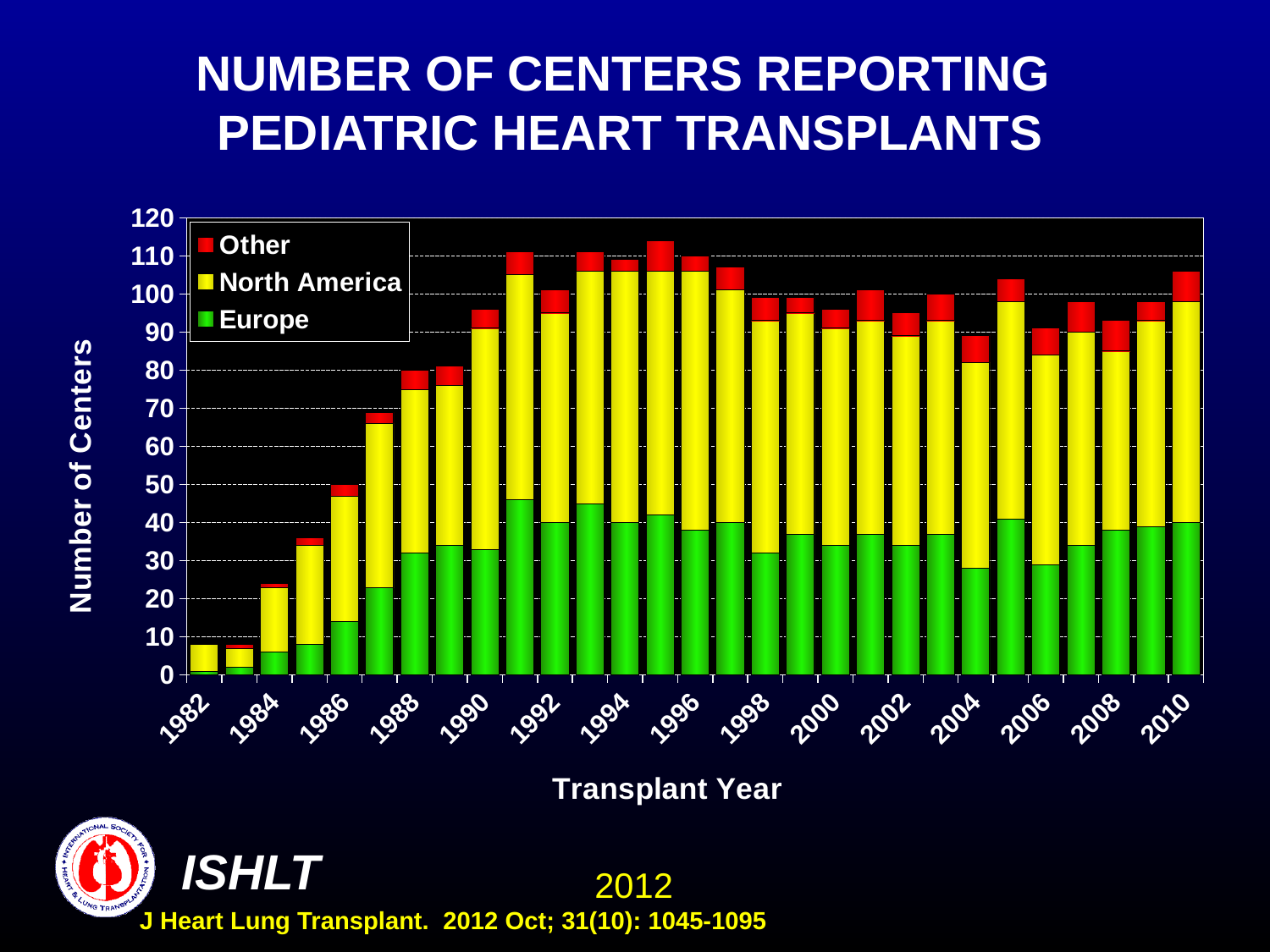
What kind of chart is shown on the slide? Stacked bar chart Is the total number of centers for 1995 greater or less than 110? greater Do the total numbers of centers rise or fall from 1982 to 1991? rise How many series does the legend list? 3 Is the Europe value for 1991 greater or less than 40? greater Which colour represents Europe in the chart? Green How many transplant years (bars) are plotted in the chart? 29 Is the total number of centers for 1982 greater or less than 10? less Which has a larger Europe value, 1991 or 2004? 1991 What is the label on the y axis of the chart? Number of Centers